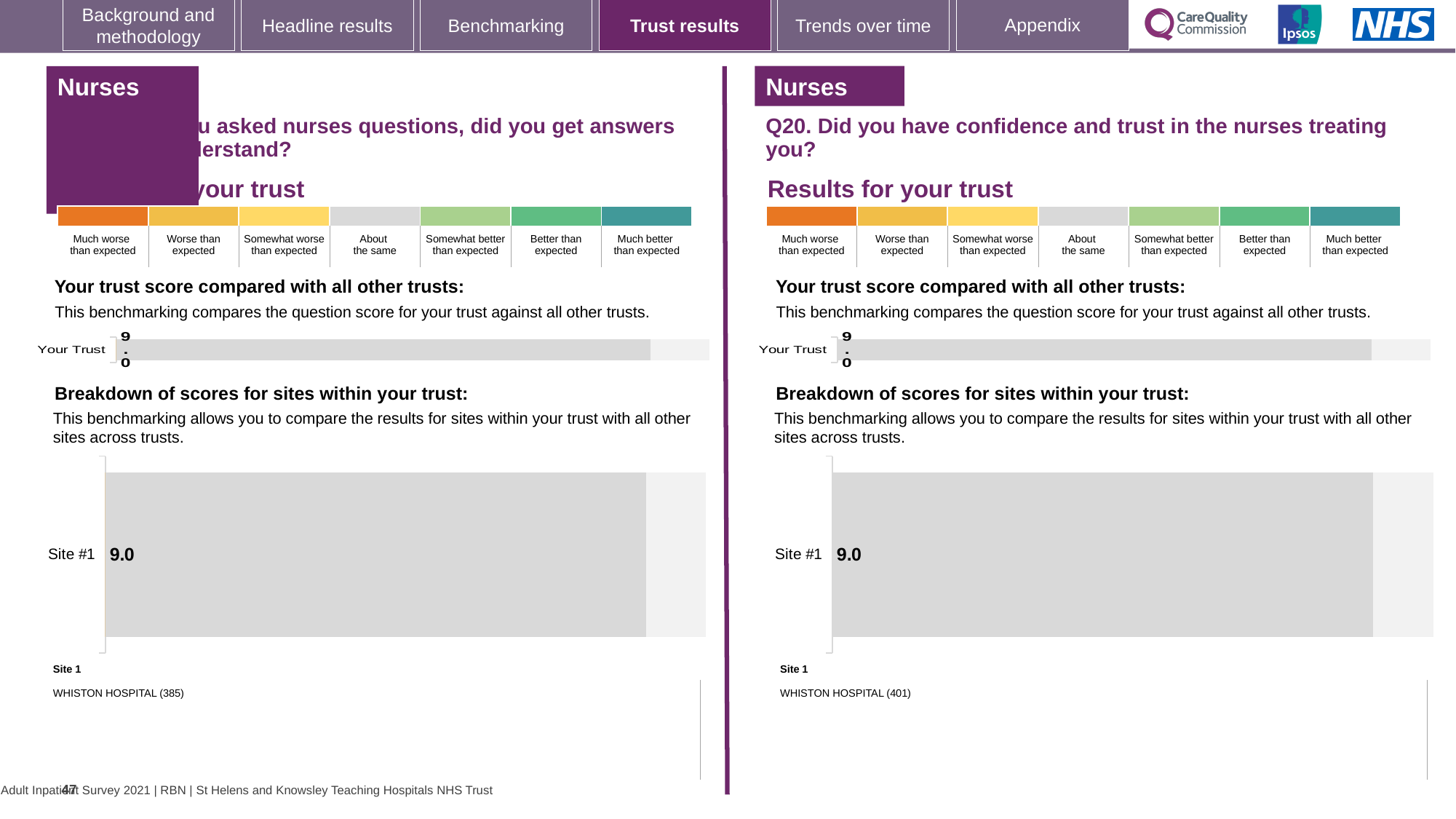
On the right half of the slide (Q20), how many sites are shown in the 'Breakdown of scores for sites within your trust' chart? 1 On the left half of the slide, how many sites are shown in the 'Breakdown of scores for sites within your trust' chart? 1 On the right half of the slide (Q20), is the Site #1 score in the breakdown chart greater or less than the Your Trust score in the trust chart, or are they equal? Equal On the right half of the slide (Q20), in the 'Your trust score compared with all other trusts' chart, what is the value for Your Trust? 9.0 On the left half of the slide, in the 'Your trust score compared with all other trusts' chart, what is the value for Your Trust? 9.0 What type of chart is used for the 'Your trust score compared with all other trusts' section on the right half of the slide? Bar chart On the left half of the slide, which site is listed as Site 1 below the breakdown chart? WHISTON HOSPITAL (385) On the right half of the slide (Q20), in the 'Breakdown of scores for sites within your trust' chart, what is the value for Site #1? 9.0 On the left half of the slide, in the 'Breakdown of scores for sites within your trust' chart, what is the value for Site #1? 9.0 On the right half of the slide (Q20), which site is listed as Site 1 below the breakdown chart? WHISTON HOSPITAL (401) What type of chart is used for the 'Breakdown of scores for sites within your trust' section on the left half of the slide? Bar chart